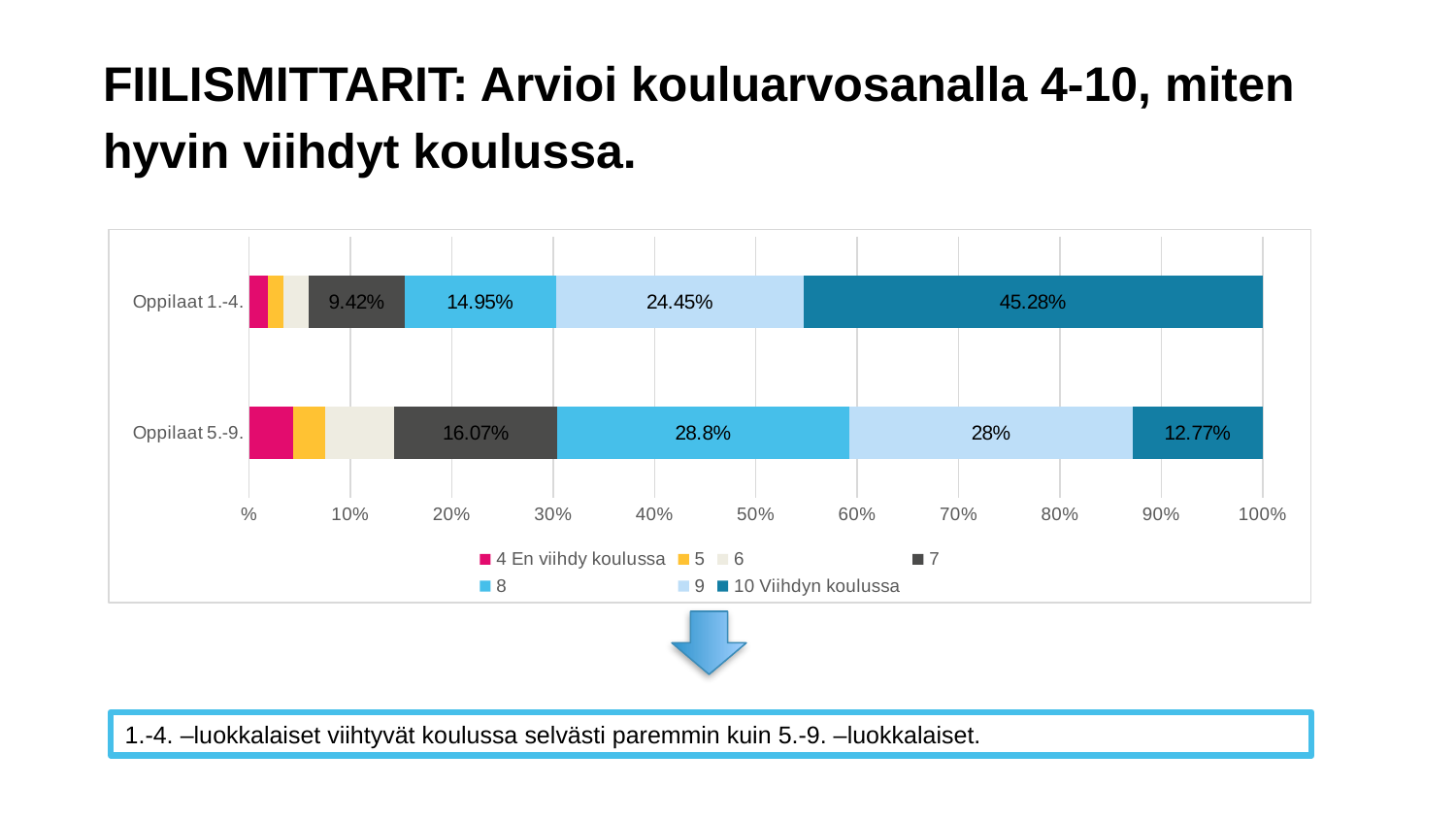
How many categories (rows) does the chart show? 2 What is the difference between the '10 Viihdyn koulussa' values for Oppilaat 1.-4. and Oppilaat 5.-9.? 32.51 percentage points What is the label of the first legend entry? 4 En viihdy koulussa What is the value of the '7' segment for Oppilaat 5.-9.? 16.07% What is the value of the '10 Viihdyn koulussa' segment for Oppilaat 1.-4.? 45.28% Which series has the largest share in the Oppilaat 1.-4. bar? 10 Viihdyn koulussa What kind of chart is shown on the slide? Stacked bar chart How many series does the legend list? 7 Which is larger: the '7' segment for Oppilaat 1.-4. or for Oppilaat 5.-9.? Oppilaat 5.-9. What is the value of the '8' segment for Oppilaat 5.-9.? 28.8% Is the value of the '4 En viihdy koulussa' segment for Oppilaat 5.-9. greater or less than 10%? less What is the value of the '9' segment for Oppilaat 1.-4.? 24.45%